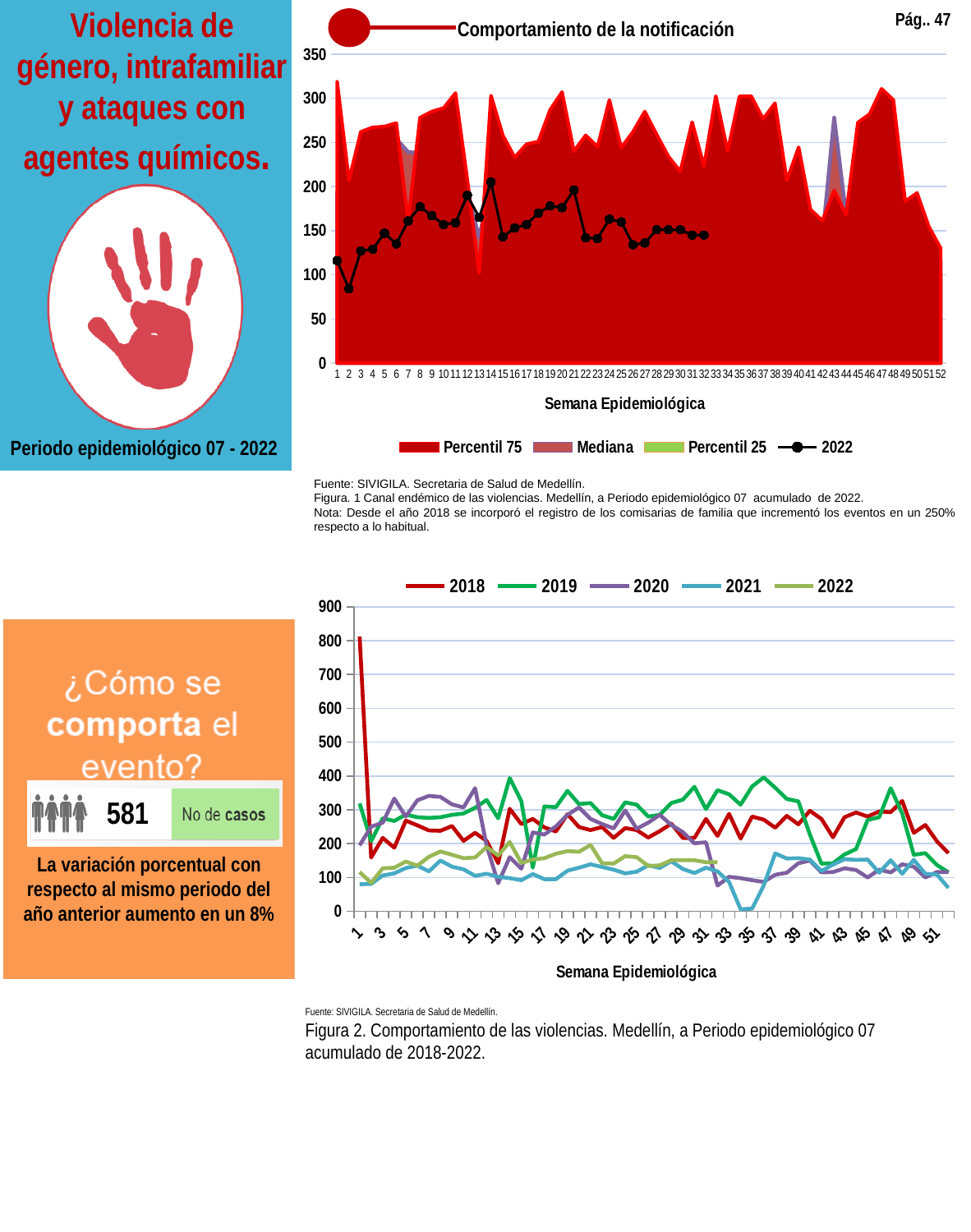
In the chart titled 'Comportamiento de la notificación', is the value of the Percentil 75 area at week 1 greater or less than 300? greater In the bottom chart (Figura 2), is the value of the 2018 series at week 1 greater or less than 700? greater In the chart titled 'Comportamiento de la notificación', what is the label of the x axis? Semana Epidemiológica In the chart titled 'Comportamiento de la notificación', how many series does the legend list? 4 In the bottom chart (Figura 2), is the value of the 2019 series at week 15 greater or less than 300? greater What kind of chart is the bottom chart (Figura 2)? line chart In the bottom chart (Figura 2), how many series does the legend list? 5 In the bottom chart (Figura 2), which series reaches the highest value on the chart? 2018 In the chart titled 'Comportamiento de la notificación', how many epidemiological weeks are shown on the x axis? 52 In the chart titled 'Comportamiento de la notificación', what is the highest value shown on the y axis? 350